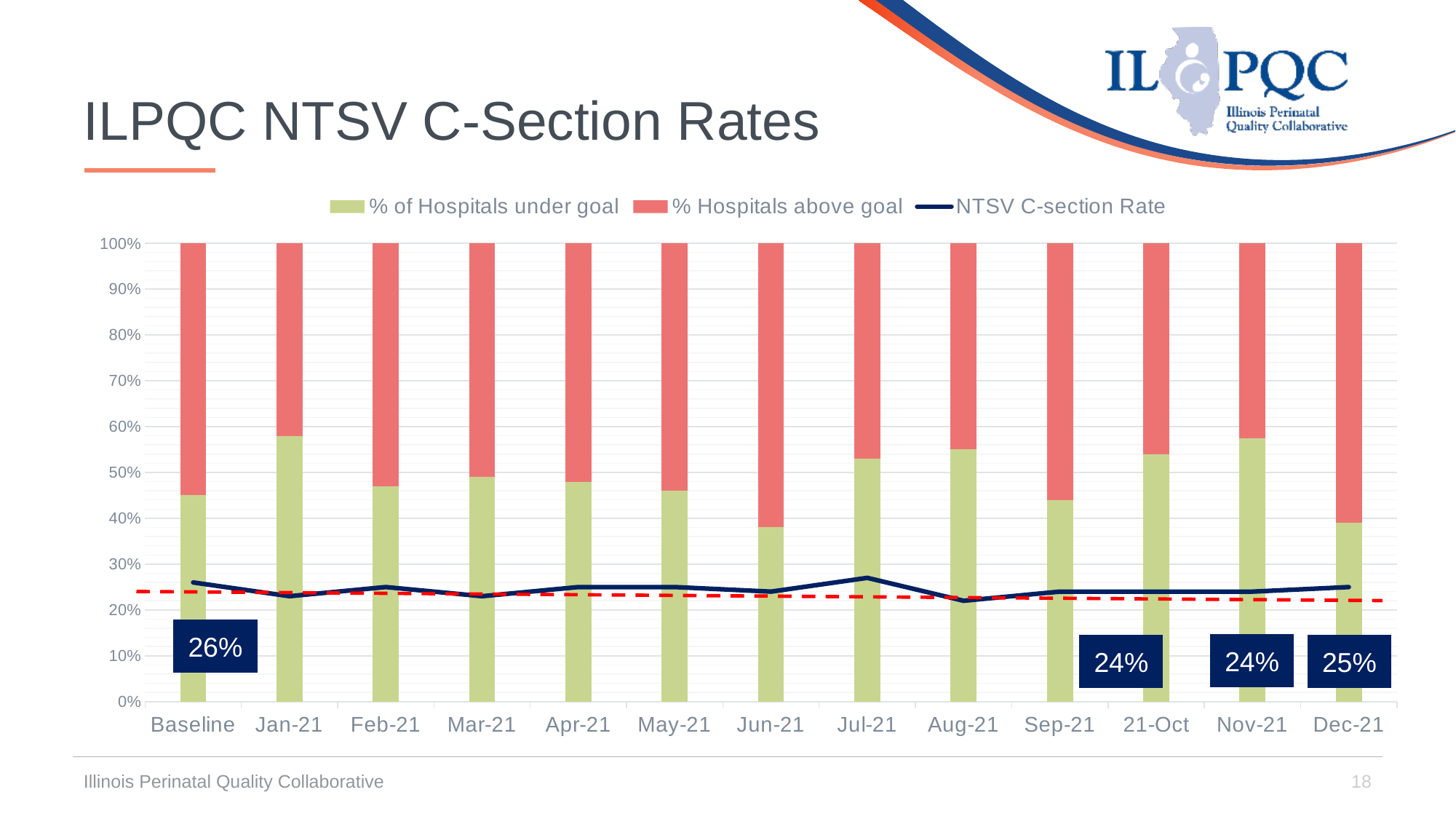
Which has a larger % of Hospitals under goal, Jan-21 or Jun-21? Jan-21 How many time periods are shown on the x axis? 13 What is the NTSV C-section Rate for Dec-21? 25% What kind of chart is shown on the slide? Stacked bar chart with a line What is the NTSV C-section Rate for Nov-21? 24% What is the NTSV C-section Rate for Sep-21? 24% Is the % of Hospitals under goal for Jan-21 greater or less than 50%? greater Which is larger, the NTSV C-section Rate in Sep-21 or in Dec-21? Dec-21 What is the NTSV C-section Rate at Baseline? 26% Is the % of Hospitals under goal for Baseline greater or less than 50%? less By how many percentage points does the NTSV C-section Rate at Baseline exceed the rate in Dec-21? 1 percentage point How many series does the legend list? 3